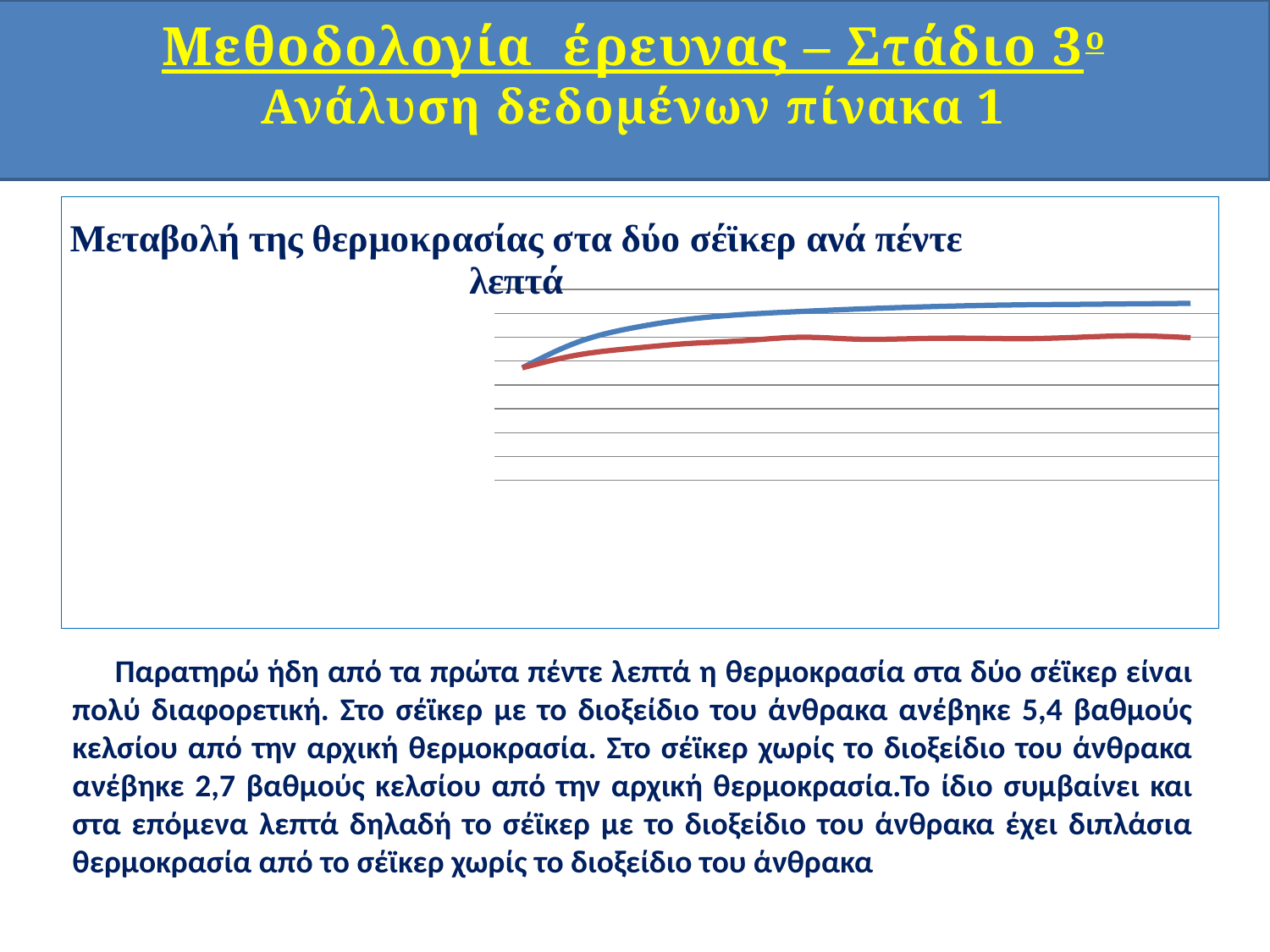
Do the values of the red line rise or fall overall from left to right? rise What kind of chart is shown on the slide? line chart What is the title of the chart? Μεταβολή της θερμοκρασίας στα δύο σέϊκερ ανά πέντε λεπτά Do the values of the blue line rise or fall from left to right? rise Which line ends higher at the right side of the chart, the blue line or the red line? the blue line What colours are the two lines on the chart? blue and red How many lines are plotted on the chart? 2